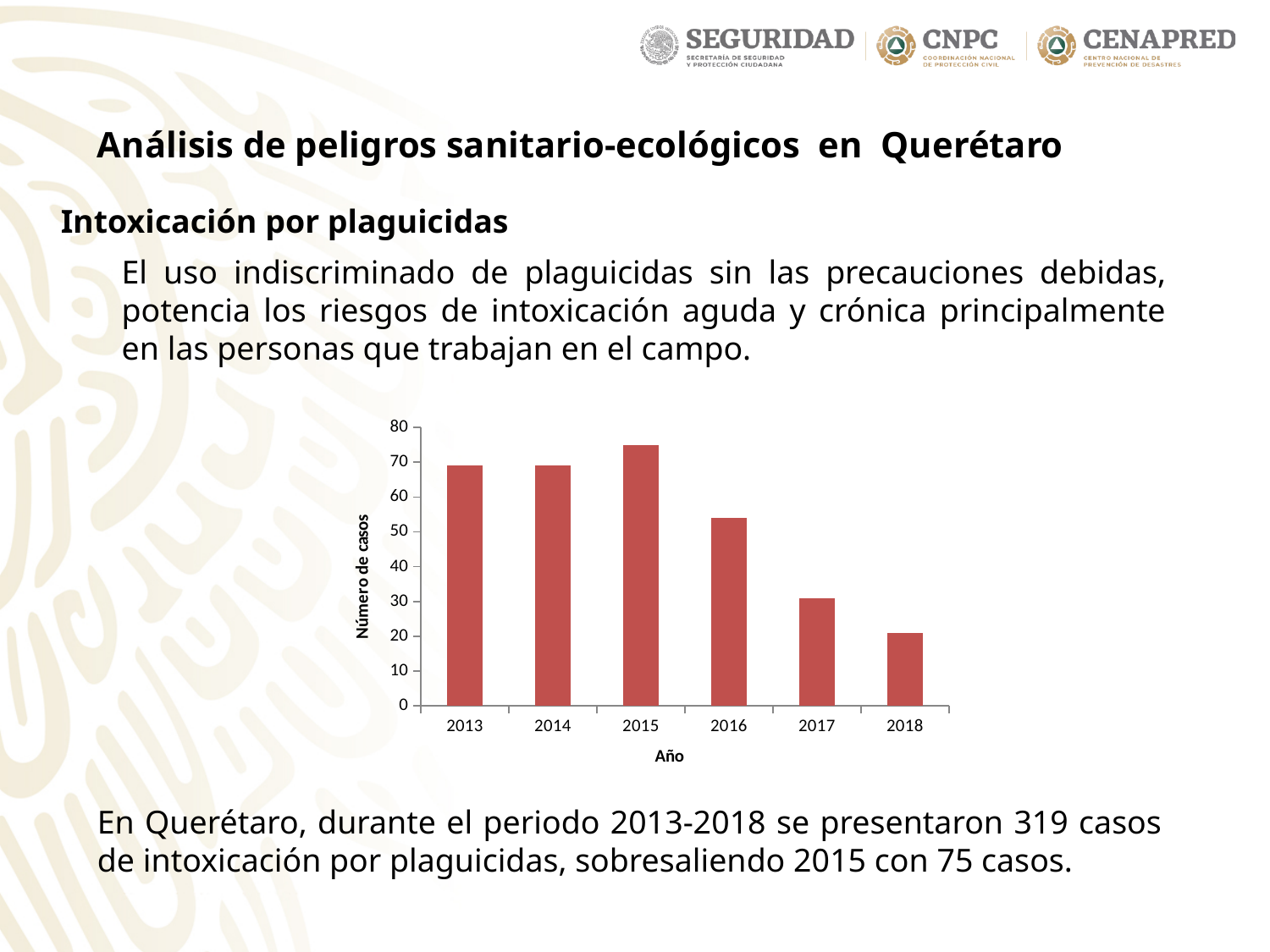
Is the value for 2018 greater or less than 30? less Do the values rise or fall from 2015 to 2018? fall What kind of chart is shown on the slide? bar chart Is the value for 2017 greater or less than 40? less According to the slide, how many cases were recorded in 2015? 75 Which year has the highest number of cases in the chart? 2015 Which year has the lowest number of cases in the chart? 2018 Is the value for 2013 greater or less than 60? greater What is the label of the vertical axis of the chart? Número de casos How many years are shown on the x axis of the chart? 6 Which year has more cases, 2016 or 2017? 2016